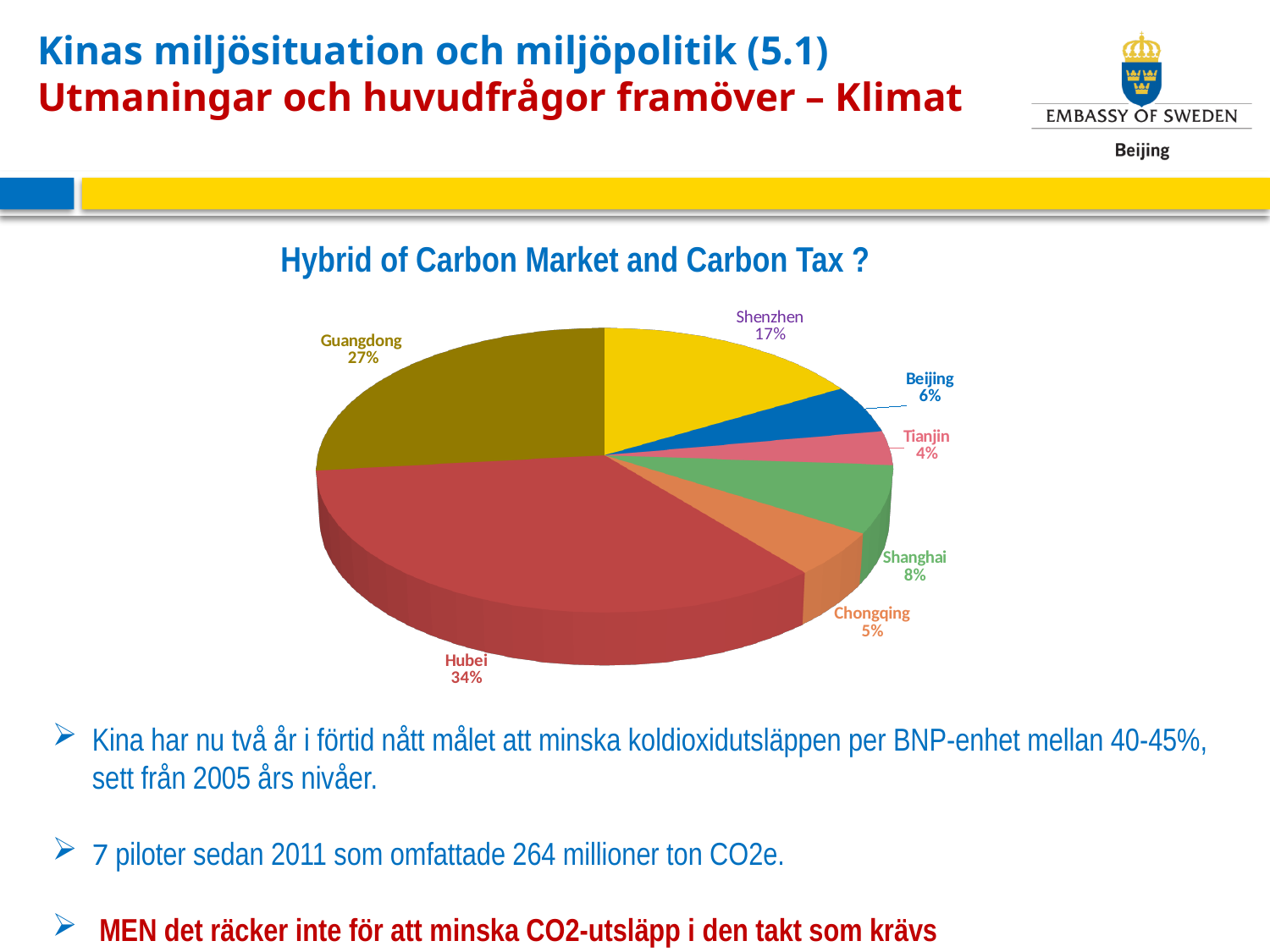
What is the difference in percentage points between Hubei and Guangdong? 7 What share of the pie does Shenzhen have? 17% What is the title of the chart? Hybrid of Carbon Market and Carbon Tax ? What share of the pie does Guangdong have? 27% What share of the pie does Hubei have? 34% What kind of chart is shown on the slide? Pie chart Which slice of the pie is the smallest? Tianjin Which is larger, Shanghai or Chongqing? Shanghai Which slice of the pie is the largest? Hubei What share of the pie does Tianjin have? 4% What is the combined share of Beijing and Tianjin? 10% How many slices does the pie chart have? 7